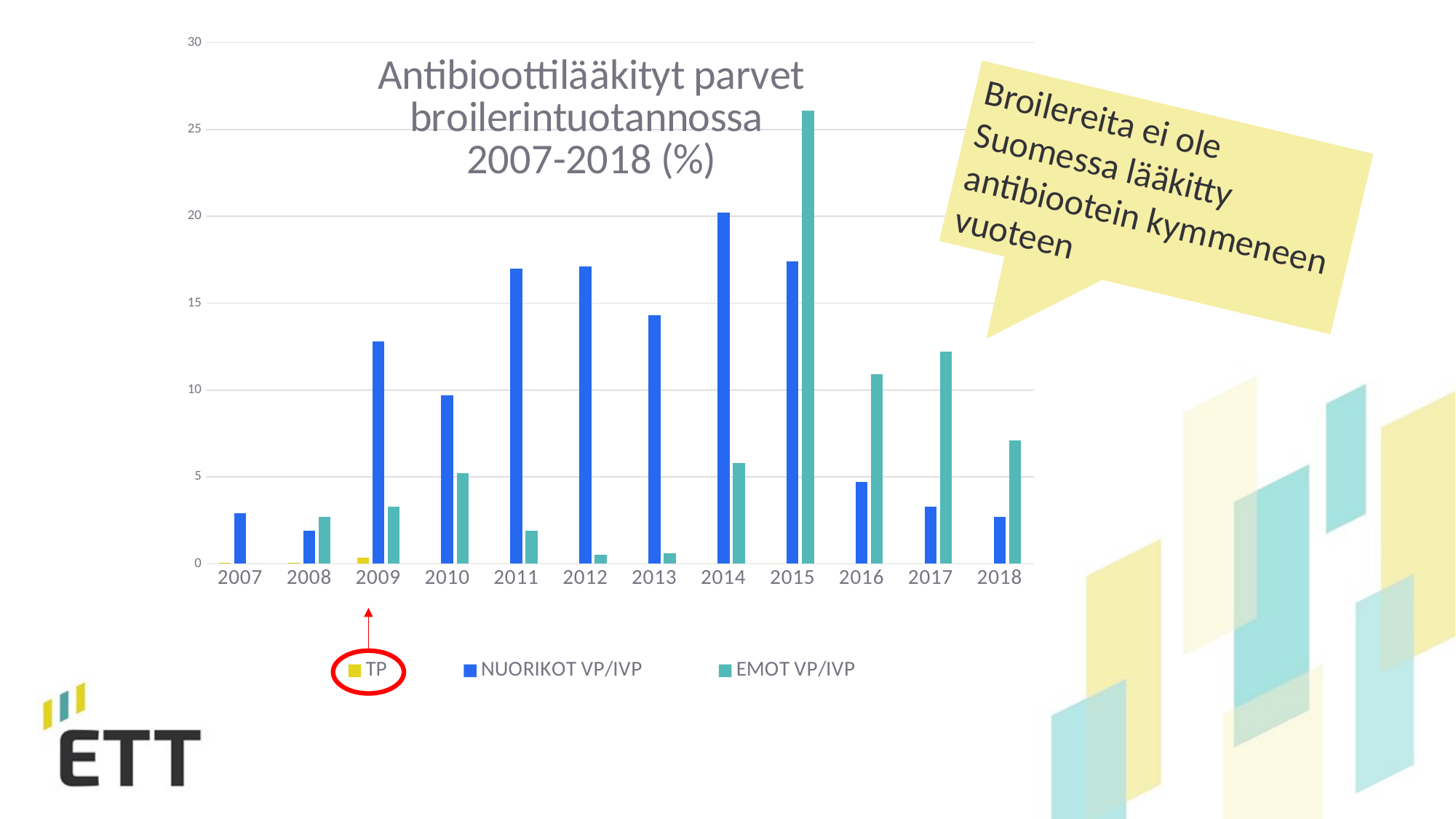
In 2011, which series has the larger value, NUORIKOT VP/IVP or EMOT VP/IVP? NUORIKOT VP/IVP In which year is the NUORIKOT VP/IVP value highest? 2014 Is the NUORIKOT VP/IVP value for 2014 greater or less than 15? greater In which year is the EMOT VP/IVP value highest? 2015 Is the EMOT VP/IVP value for 2015 greater or less than 25? greater Is the NUORIKOT VP/IVP value for 2009 greater or less than 10? greater How many series does the legend list? 3 How many years are shown on the x axis? 12 Does the NUORIKOT VP/IVP value rise or fall from 2015 to 2018? fall In 2015, which series has the larger value, NUORIKOT VP/IVP or EMOT VP/IVP? EMOT VP/IVP What kind of chart is shown on the slide? bar chart